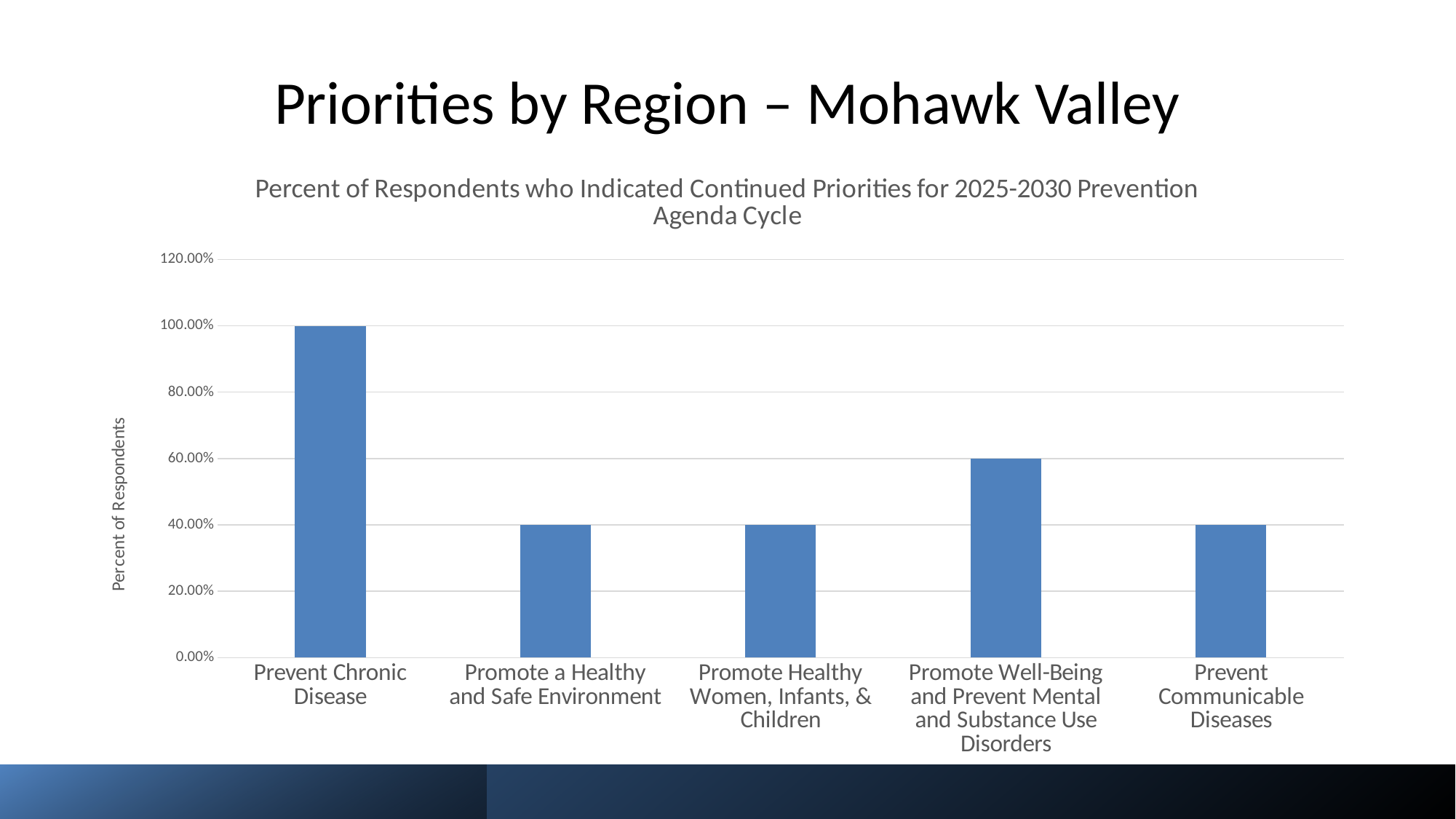
What type of chart is shown on the slide? bar chart Is the value for Promote a Healthy and Safe Environment greater or less than 60.00%? less What is the value for Prevent Communicable Diseases? 40.00% What is the label on the vertical axis of the chart? Percent of Respondents Which is larger, the value for Promote Well-Being and Prevent Mental and Substance Use Disorders or the value for Promote Healthy Women, Infants, & Children? Promote Well-Being and Prevent Mental and Substance Use Disorders Which category has the highest value? Prevent Chronic Disease What is the value for Prevent Chronic Disease? 100.00% What is the value for Promote Well-Being and Prevent Mental and Substance Use Disorders? 60.00% Is the value for Prevent Chronic Disease greater or less than 80.00%? greater What is the title of the chart? Percent of Respondents who Indicated Continued Priorities for 2025-2030 Prevention Agenda Cycle How many categories are shown on the x axis of the chart? 5 What is the difference between the values for Prevent Chronic Disease and Promote Well-Being and Prevent Mental and Substance Use Disorders? 40.00%